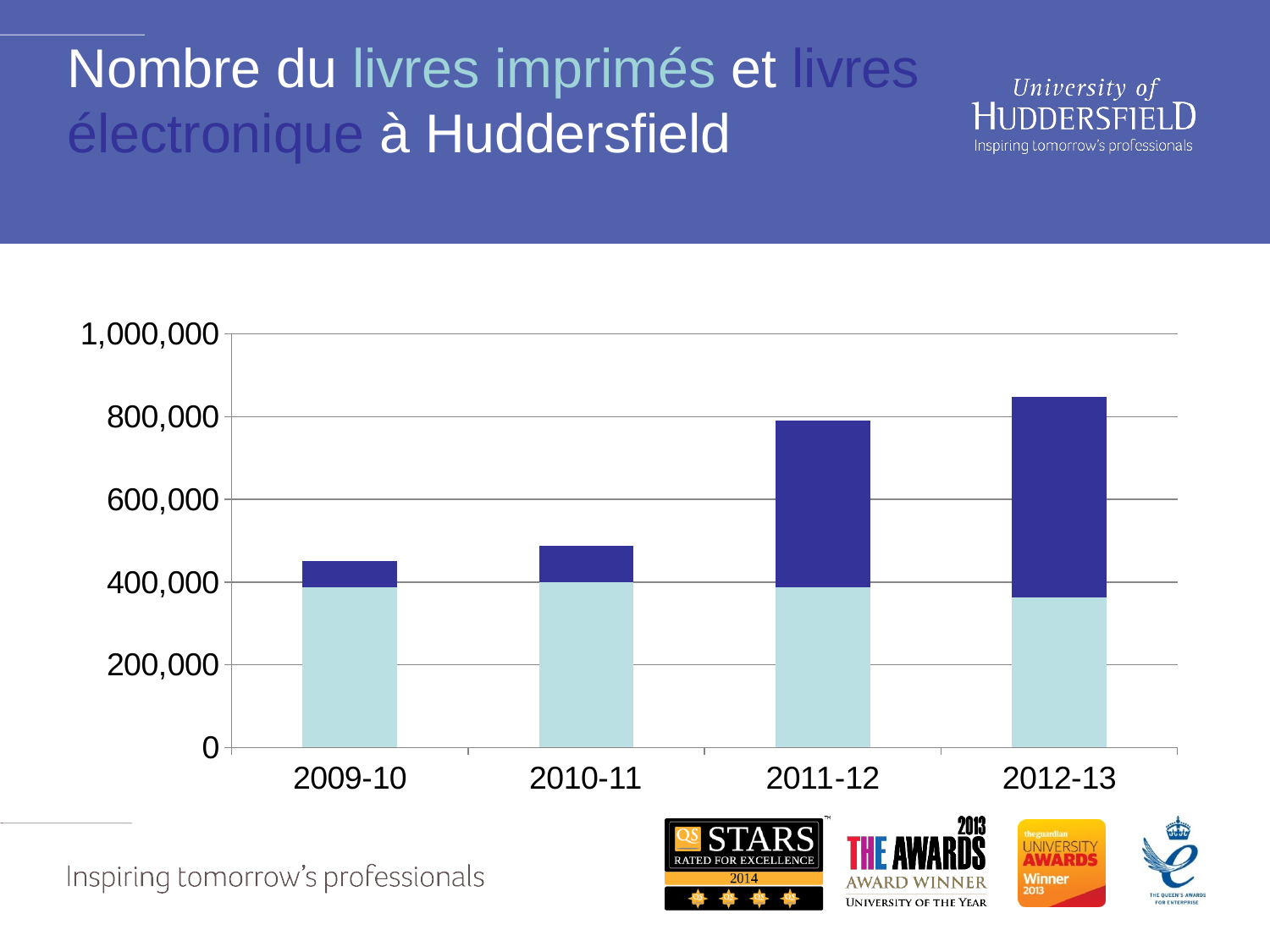
What colour is the bottom segment of each stacked bar in the chart? Light blue Is the total height of the bar for 2009-10 greater or less than 600,000? less How many academic years are shown on the x axis of the chart? 4 Do the total bar heights rise or fall from 2009-10 to 2012-13? rise What kind of chart is shown on the slide? Stacked bar chart Is the total height of the bar for 2010-11 greater or less than 600,000? less Which year has the tallest stacked bar in the chart? 2012-13 What is the title of the slide containing the chart? Nombre du livres imprimés et livres électronique à Huddersfield Is the total height of the bar for 2012-13 greater or less than 800,000? greater Which year has a taller stacked bar, 2010-11 or 2011-12? 2011-12 Which year has the shortest stacked bar in the chart? 2009-10